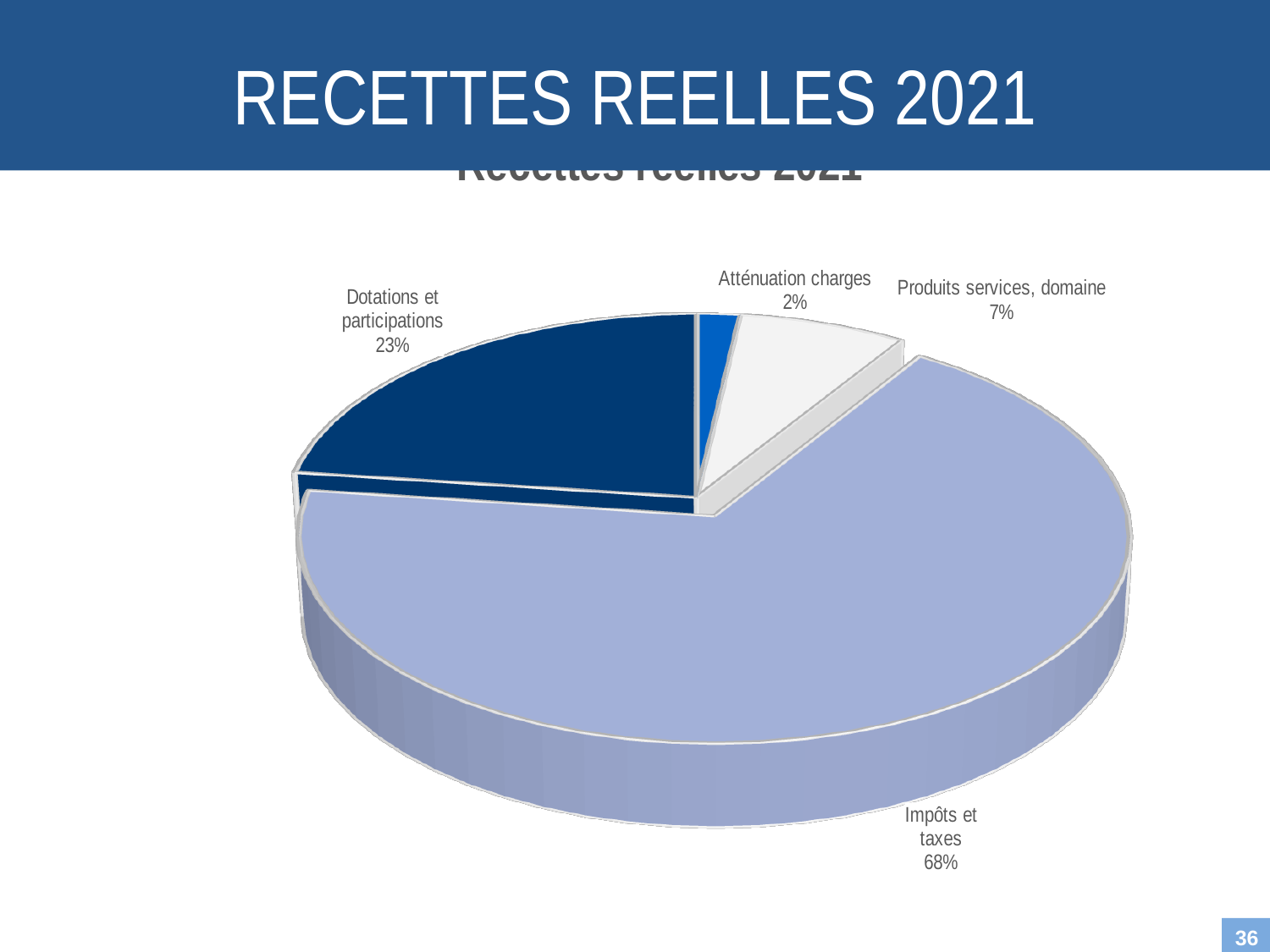
How many slices does the pie chart have? 4 What share of the pie does Dotations et participations represent? 23% What is the value shown for Produits services, domaine? 7% Which is larger, Produits services, domaine or Atténuation charges? Produits services, domaine What kind of chart is shown on the slide? pie chart What is the title of the slide? RECETTES REELLES 2021 What is the value shown for Atténuation charges? 2% Which category has the largest slice of the pie? Impôts et taxes Which category has the smallest slice of the pie? Atténuation charges What share of the pie does Impôts et taxes represent? 68% What is the difference in percentage points between Dotations et participations and Produits services, domaine? 16 What is the difference in percentage points between Impôts et taxes and Dotations et participations? 45